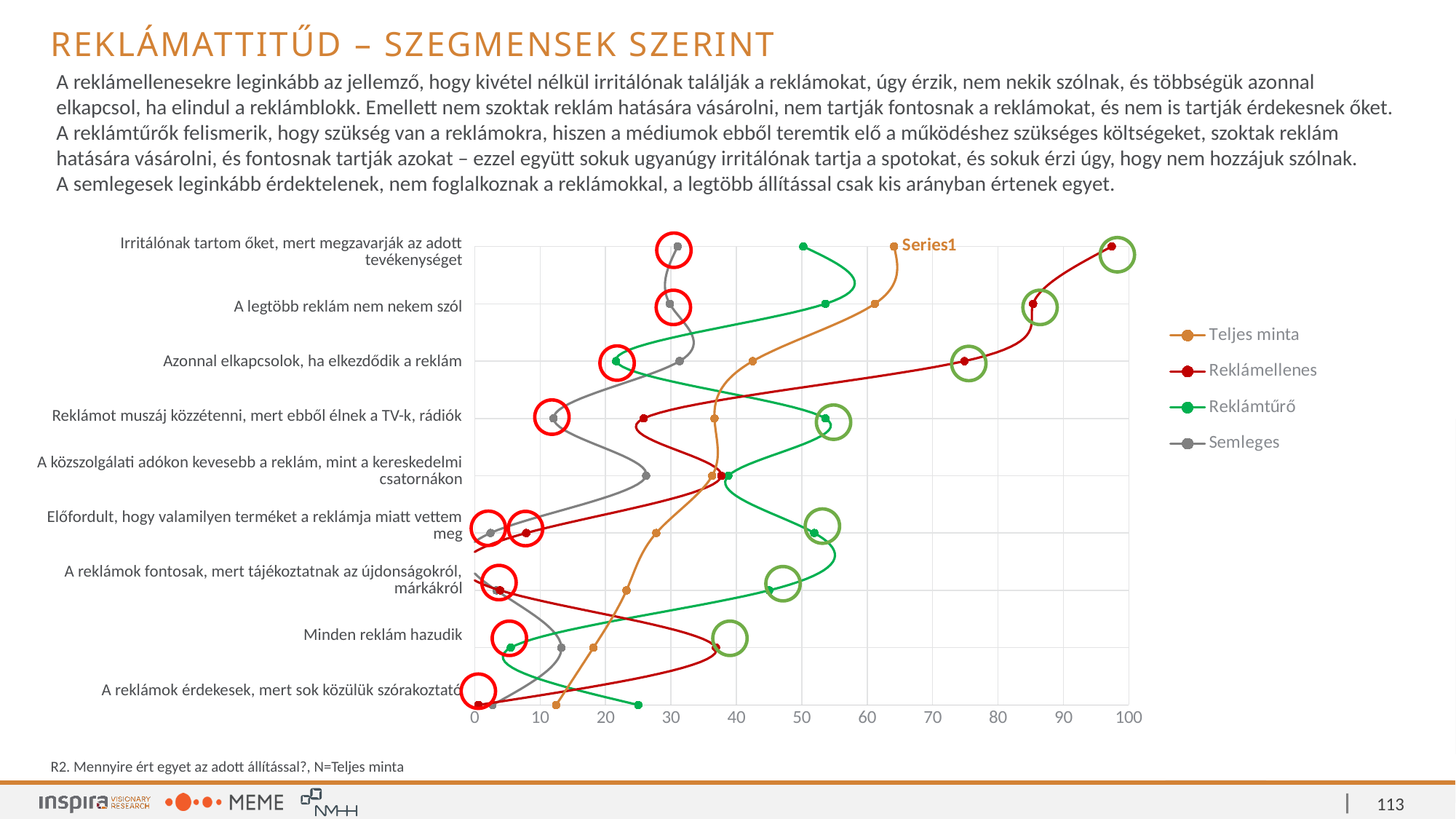
How many series does the legend list? 4 How many statements (categories) are plotted on the chart? 9 For which statement does the Reklámellenes series reach its highest value? Irritálónak tartom őket, mert megzavarják az adott tevékenységet Which series is drawn in green on the chart? Reklámtűrő Is the Reklámellenes value for "Irritálónak tartom őket, mert megzavarják az adott tevékenységet" greater or less than 90? greater What kind of chart is shown on the slide? line chart For "Előfordult, hogy valamilyen terméket a reklámja miatt vettem meg", which series has the higher value: Reklámellenes or Reklámtűrő? Reklámtűrő Is the Reklámellenes value for "A legtöbb reklám nem nekem szól" greater or less than 80? greater Is the Reklámellenes value for "Előfordult, hogy valamilyen terméket a reklámja miatt vettem meg" greater or less than 10? less For "Irritálónak tartom őket, mert megzavarják az adott tevékenységet", which series has the higher value: Reklámellenes or Reklámtűrő? Reklámellenes